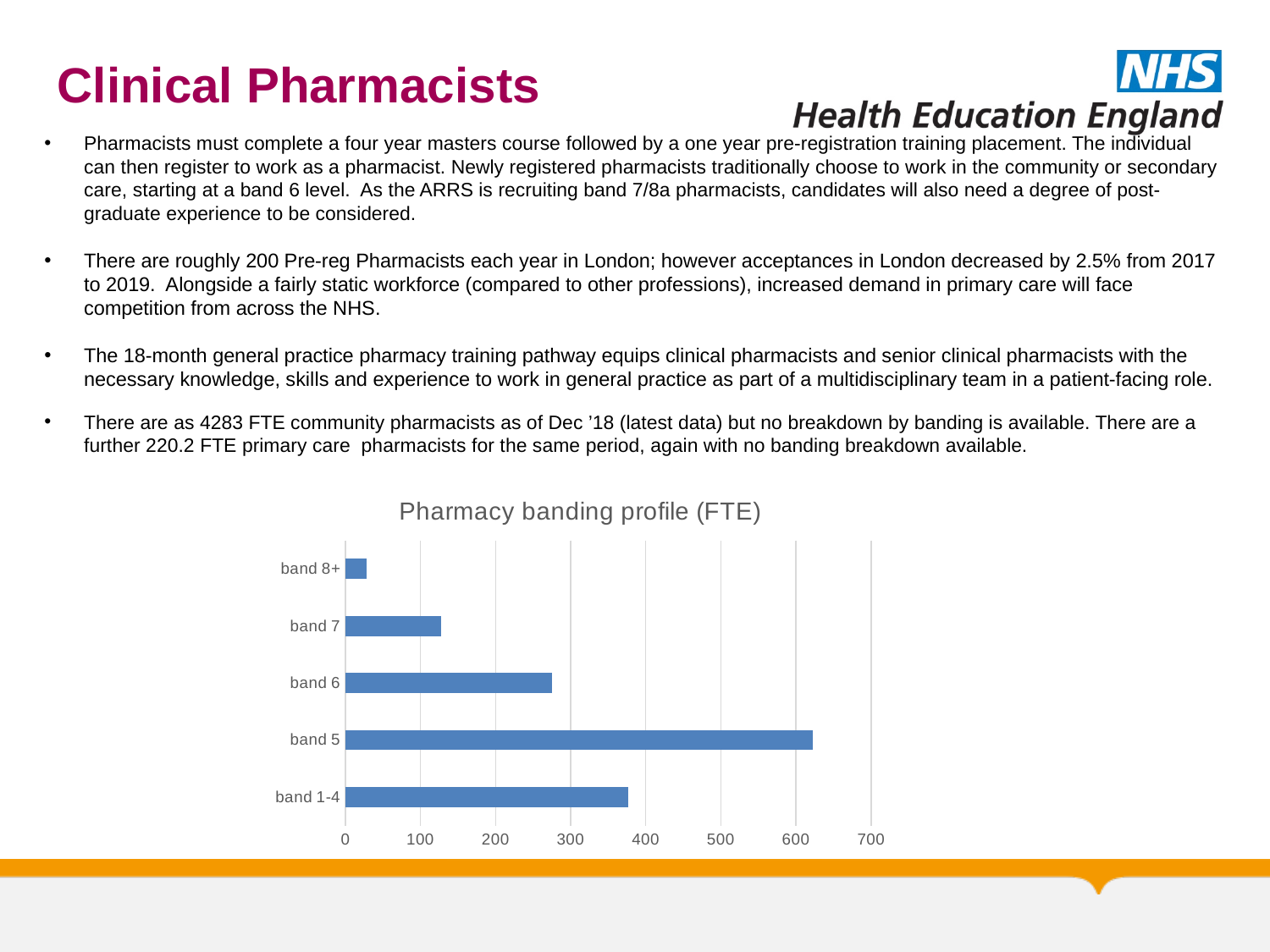
Which is larger, the value for band 1-4 or the value for band 6? band 1-4 Which band has the highest FTE value in the chart? band 5 What type of chart is shown on the slide? bar chart How many bands (categories) are shown in the chart? 5 Which band has the lowest FTE value in the chart? band 8+ Is the value for band 1-4 greater or less than 400? less Is the value for band 8+ greater or less than 100? less Is the value for band 7 greater or less than 100? greater Which is larger, the value for band 7 or the value for band 5? band 5 What is the title of the chart? Pharmacy banding profile (FTE)